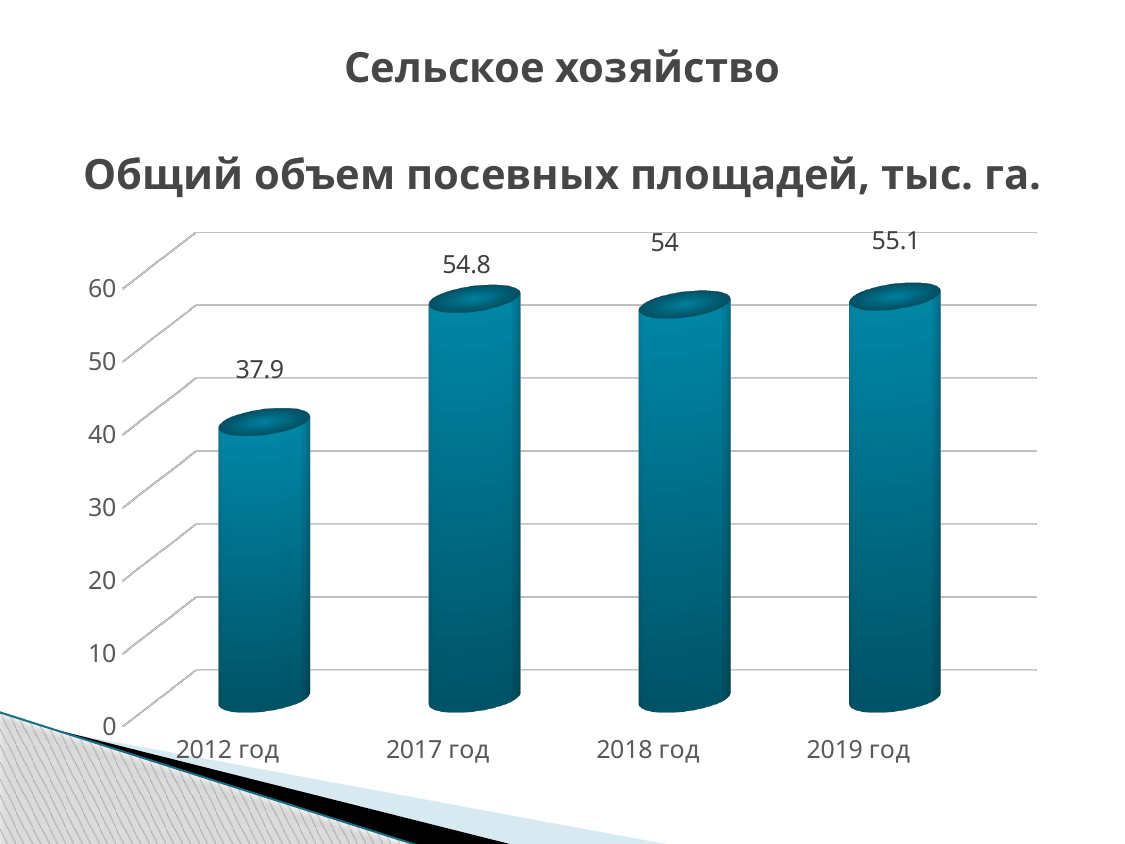
How many years are shown on the chart? 4 What is the value for 2017 год? 54.8 What is the value for 2012 год? 37.9 What is the value for 2019 год? 55.1 Which is larger, the value for 2017 год or the value for 2018 год? 2017 год Is the value for 2012 год greater or less than 40? less What kind of chart is shown on the slide? bar chart What is the difference between the values for 2019 год and 2012 год? 17.2 What is the title of the chart? Общий объем посевных площадей, тыс. га. What is the value for 2018 год? 54 Which year has the highest value? 2019 год Which year has the lowest value? 2012 год